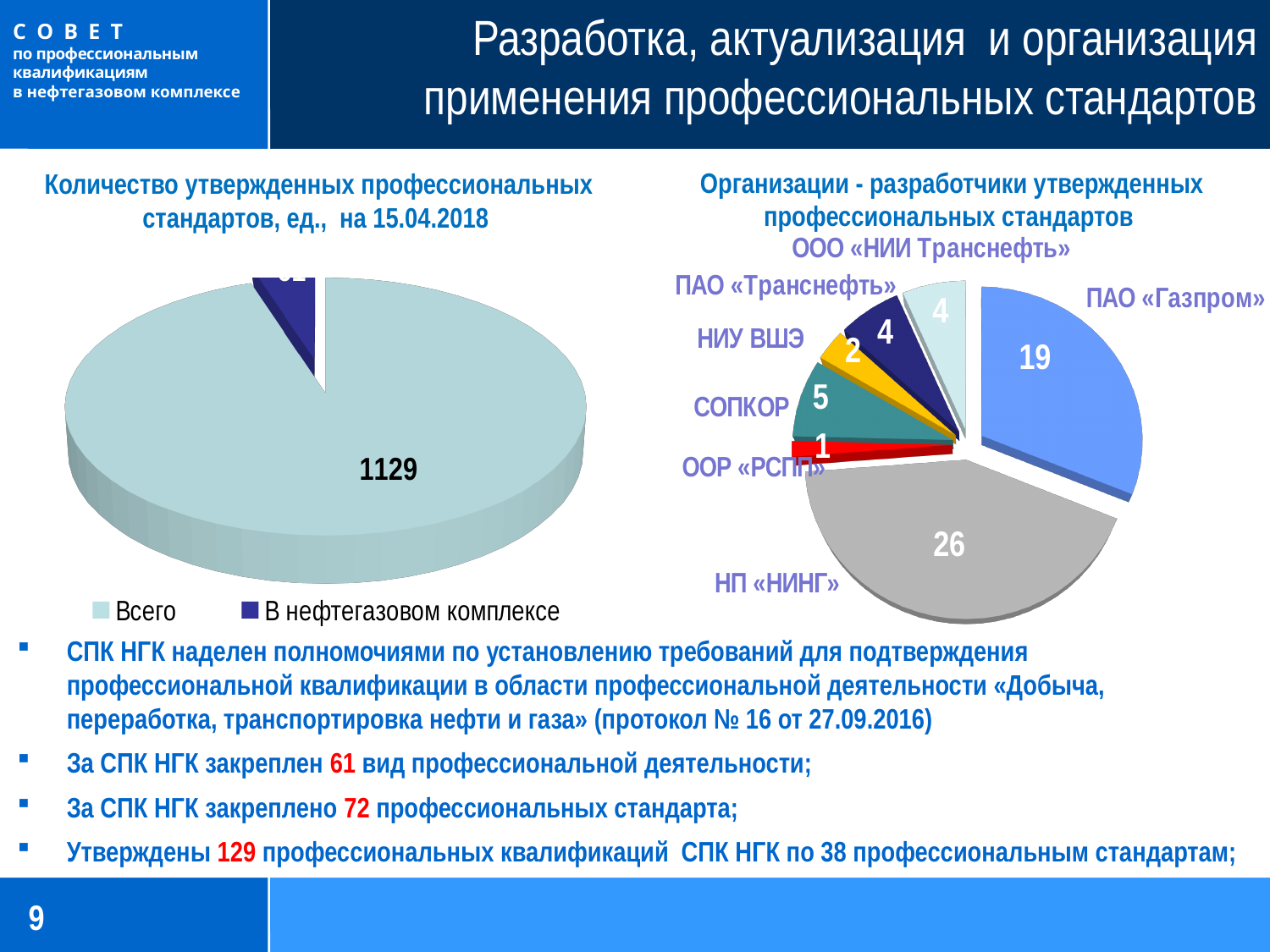
In the right chart «Организации - разработчики утвержденных профессиональных стандартов», what is the value for СОПКОР? 5 In the right chart «Организации - разработчики утвержденных профессиональных стандартов», which organization has the smallest slice? ООР «РСПП» What kind of chart is the left chart titled «Количество утвержденных профессиональных стандартов, ед., на 15.04.2018»? pie chart In the right chart «Организации - разработчики утвержденных профессиональных стандартов», what is the value for НП «НИНГ»? 26 In the right chart «Организации - разработчики утвержденных профессиональных стандартов», what is the total of all slice values? 61 In the left chart «Количество утвержденных профессиональных стандартов», what is the value for «Всего»? 1129 How many organizations (slices) are shown in the right chart «Организации - разработчики утвержденных профессиональных стандартов»? 7 In the right chart «Организации - разработчики утвержденных профессиональных стандартов», what is the difference between the values for НП «НИНГ» and ПАО «Газпром»? 7 In the right chart «Организации - разработчики утвержденных профессиональных стандартов», what is the value for ПАО «Газпром»? 19 In the right chart «Организации - разработчики утвержденных профессиональных стандартов», which is larger: the value for СОПКОР or for НИУ ВШЭ? СОПКОР In the right chart «Организации - разработчики утвержденных профессиональных стандартов», which organization has the largest slice? НП «НИНГ» How many entries does the legend of the left chart «Количество утвержденных профессиональных стандартов» list? 2